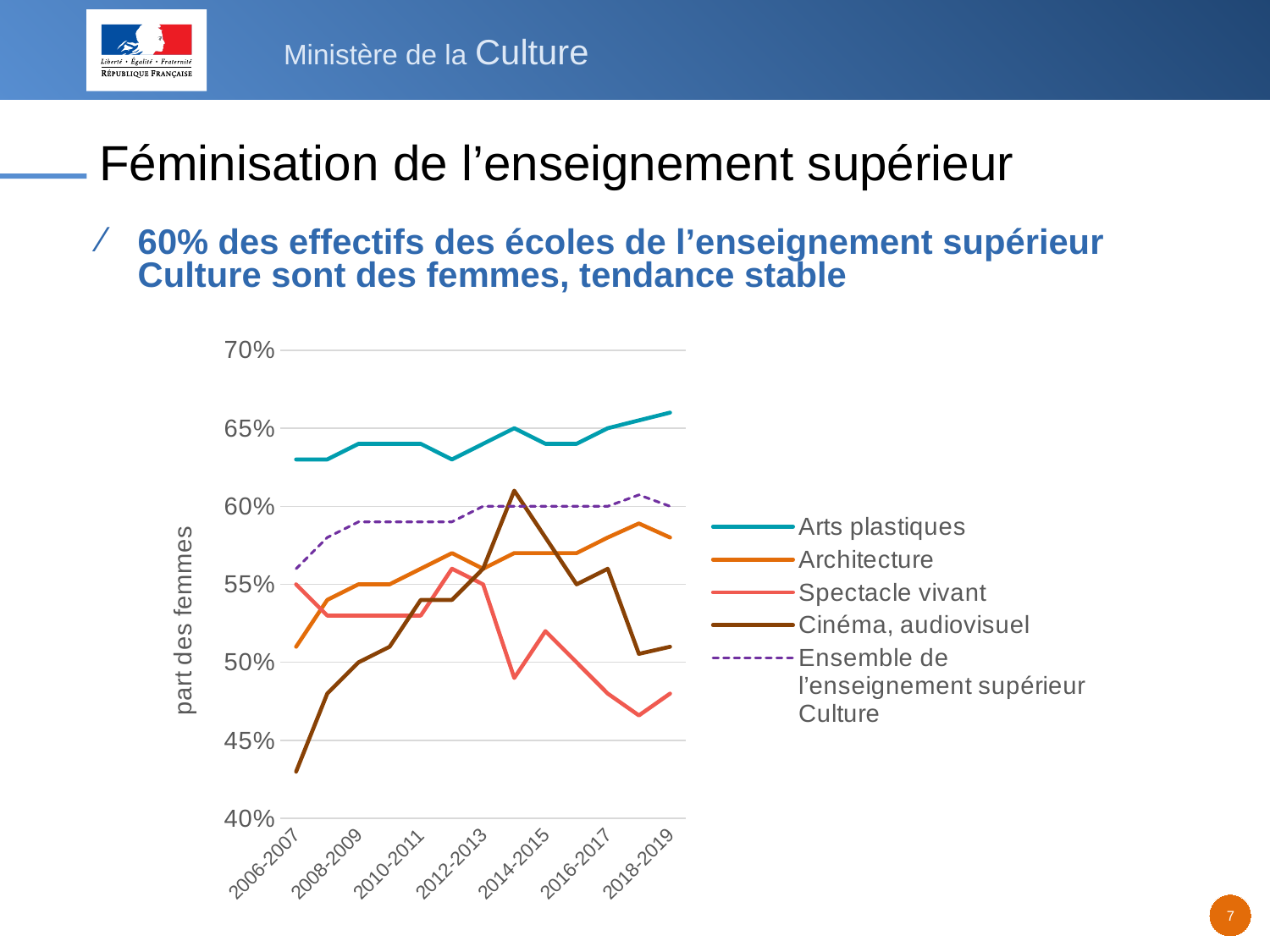
Is the value for Arts plastiques in 2006-2007 greater or less than 60%? greater Is the value for Cinéma, audiovisuel in 2006-2007 greater or less than 45%? less Which series has the lowest value in 2018-2019? Spectacle vivant What kind of chart is shown on the slide? line chart What is the label of the vertical axis? part des femmes How many series does the legend list? 5 Is the value for Spectacle vivant in 2018-2019 greater or less than 50%? less Which series has the highest share of women across the whole period? Arts plastiques Which series has the lowest value in 2006-2007? Cinéma, audiovisuel Does the Spectacle vivant series rise or fall overall between 2006-2007 and 2018-2019? fall In 2018-2019, which is larger: Architecture or Cinéma, audiovisuel? Architecture Does the Arts plastiques series rise or fall overall between 2006-2007 and 2018-2019? rise